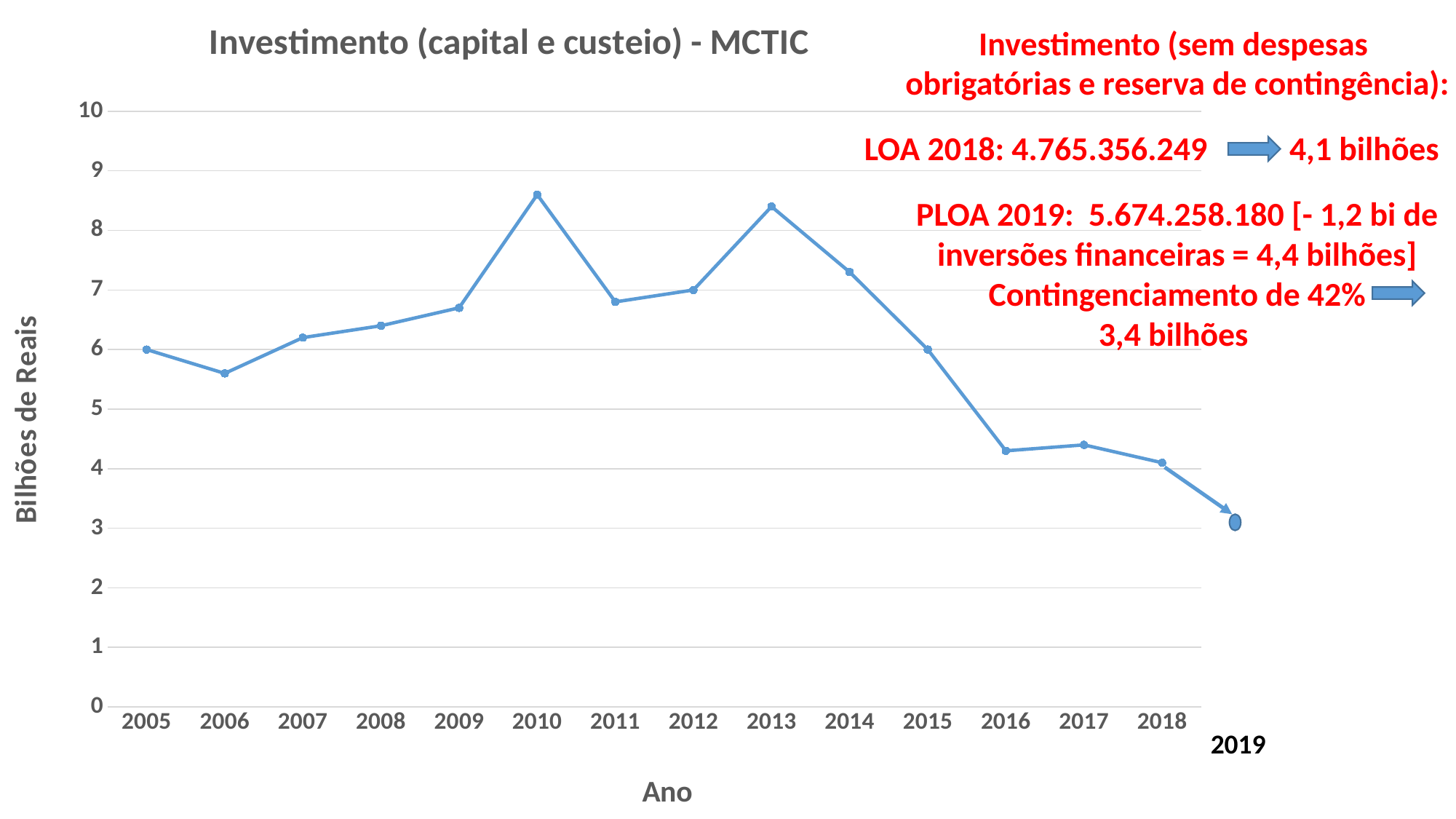
Is the value for 2016 greater or less than 5? less Which is larger, the value for 2014 or the value for 2017? 2014 How many years are plotted on the chart? 15 Which year has the highest value on the chart? 2010 What is the value for 2012 in billions of reais? 7 What kind of chart is shown on the slide? line chart Which year has the lowest value on the chart? 2019 What is the value for 2015 in billions of reais? 6 What is the label of the vertical axis of the chart? Bilhões de Reais Do the values rise or fall from 2013 to 2019? fall What is the title of the chart? Investimento (capital e custeio) - MCTIC Is the value for 2010 greater or less than 8? greater